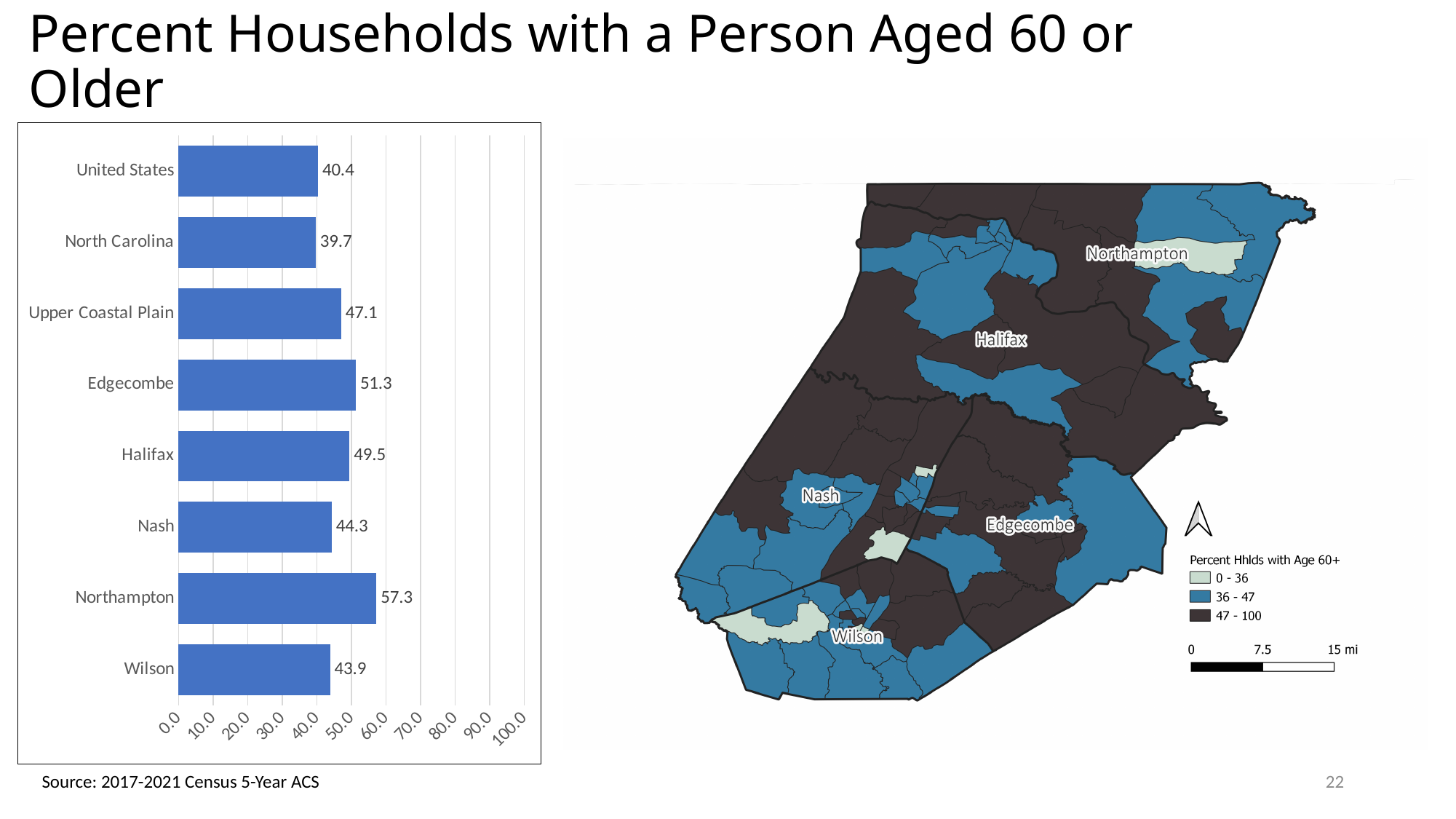
What is the value for Northampton in the bar chart? 57.3 Which has a larger value in the bar chart, Halifax or Nash? Halifax Which category has the lowest value in the bar chart? North Carolina What is the difference between the values for Edgecombe and Halifax in the bar chart? 1.8 Which category has the highest value in the bar chart? Northampton What is the value for the United States in the bar chart? 40.4 Is the value for Upper Coastal Plain in the bar chart greater or less than 40.0? greater What is the difference between the values for Northampton and Wilson in the bar chart? 13.4 What is the highest tick value shown on the x axis of the bar chart? 100.0 What is the value for Edgecombe in the bar chart? 51.3 What kind of chart is shown on the left of the slide? bar chart How many categories are shown in the bar chart? 8